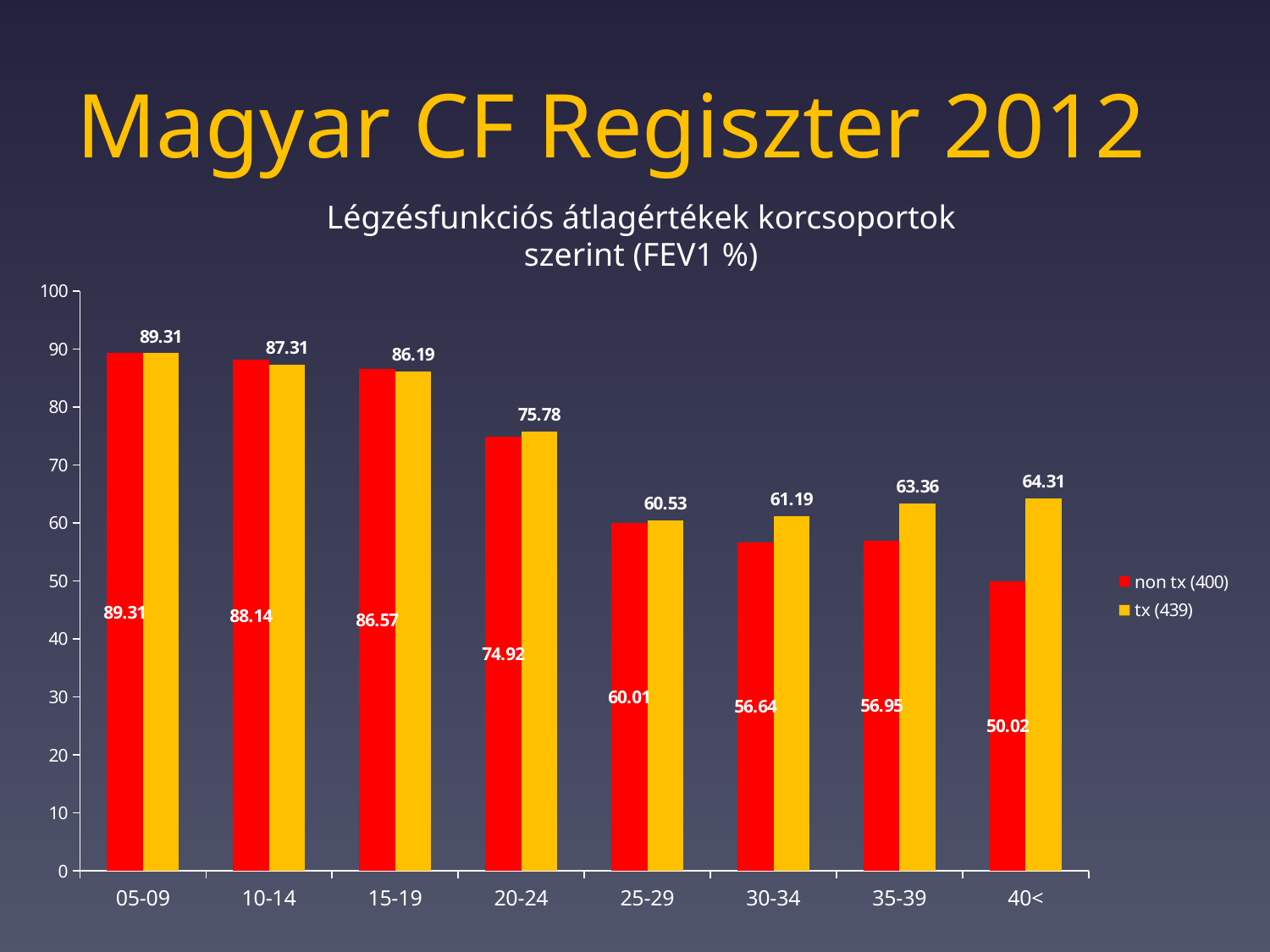
Do the non tx (400) values generally rise or fall from the 05-09 group to the 40< group? fall Is the value for non tx (400) in the 35-39 age group greater or less than 60? less What is the difference between tx (439) and non tx (400) in the 40< age group? 14.29 What is the value for non tx (400) in the 20-24 age group? 74.92 What kind of chart is shown on the slide? bar chart How many age groups are shown on the x axis? 8 How many series does the legend list? 2 In the 30-34 age group, which series has the larger value, non tx (400) or tx (439)? tx (439) What is the value for tx (439) in the 35-39 age group? 63.36 Which age group has the lowest value for non tx (400)? 40< Which age group has the highest value for tx (439)? 05-09 What is the value for non tx (400) in the 40< age group? 50.02